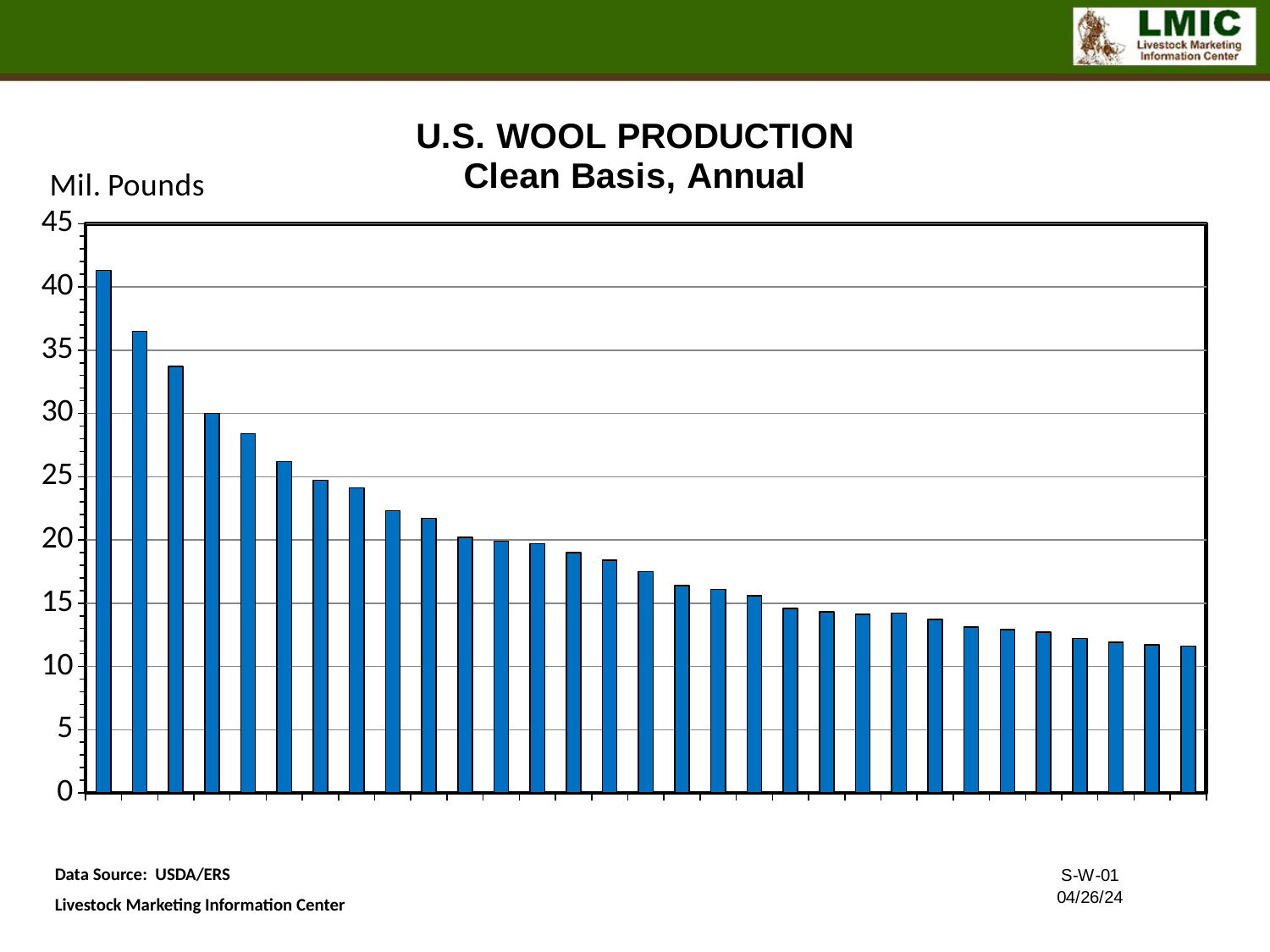
Which bar is the lowest, the leftmost or the rightmost? rightmost What unit is shown on the y axis of the chart? Mil. Pounds Is the value of the rightmost bar greater or less than 10? greater Which bar is the highest, the leftmost or the rightmost? leftmost Is the value of the leftmost bar greater or less than 40? greater Is the value of the rightmost bar greater or less than 15? less What kind of chart is shown on the slide? bar chart Which is larger, the leftmost bar or the second bar from the left? leftmost bar What is the title of the chart? U.S. WOOL PRODUCTION Clean Basis, Annual Do the values generally rise or fall from left to right along the x axis? fall